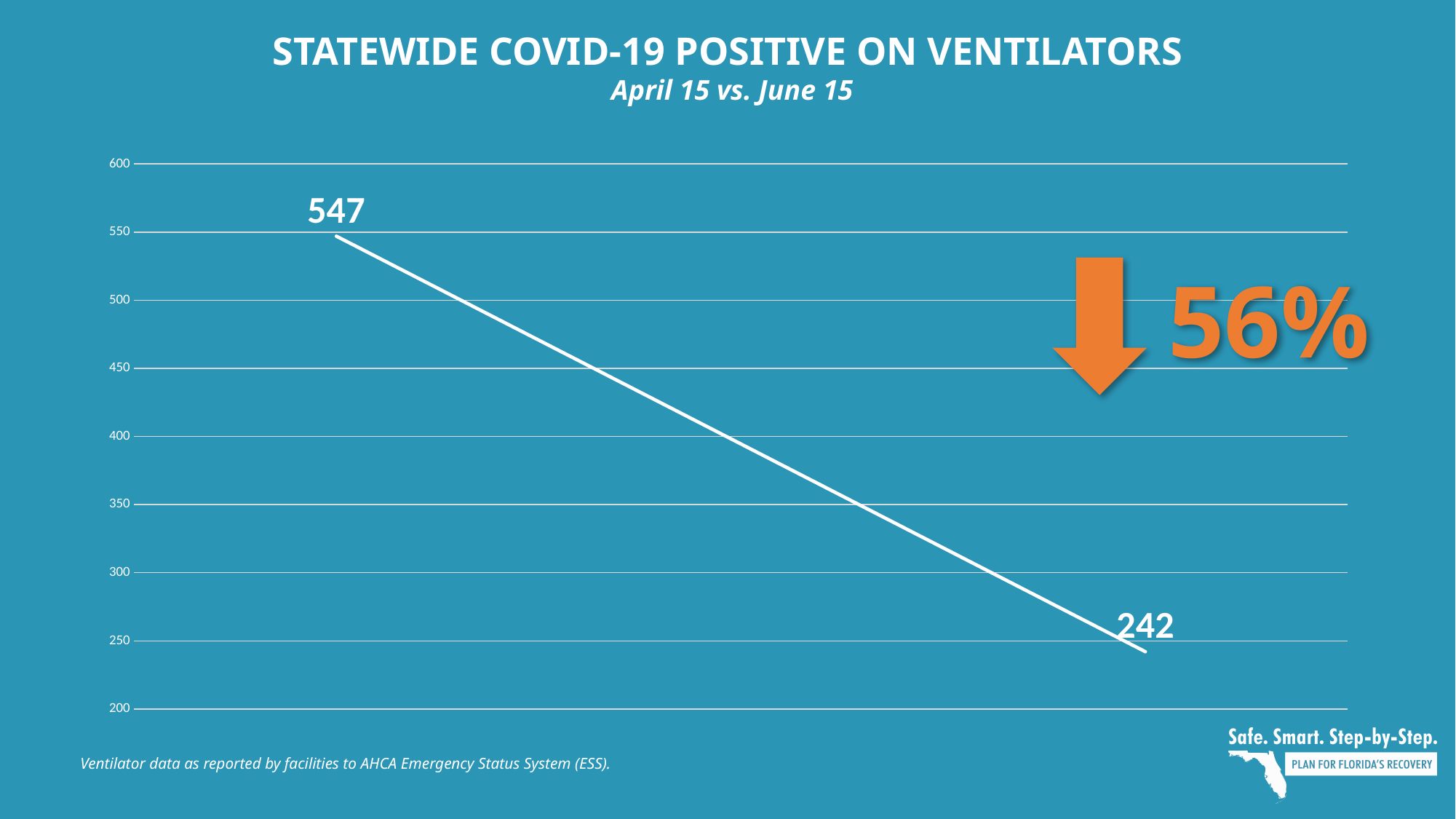
What percentage change is highlighted next to the orange arrow? 56% What is the title of the chart? STATEWIDE COVID-19 POSITIVE ON VENTILATORS What kind of chart is shown on the slide? line chart Which date has the higher value, April 15 or June 15? April 15 What is the value for April 15? 547 Is the value for April 15 greater or less than 500? greater What is the value for June 15? 242 What is the difference between the April 15 value and the June 15 value? 305 How many data points are plotted on the chart? 2 Do the values rise or fall from April 15 to June 15? fall Which date has the lowest value? June 15 Is the value for June 15 greater or less than 250? less